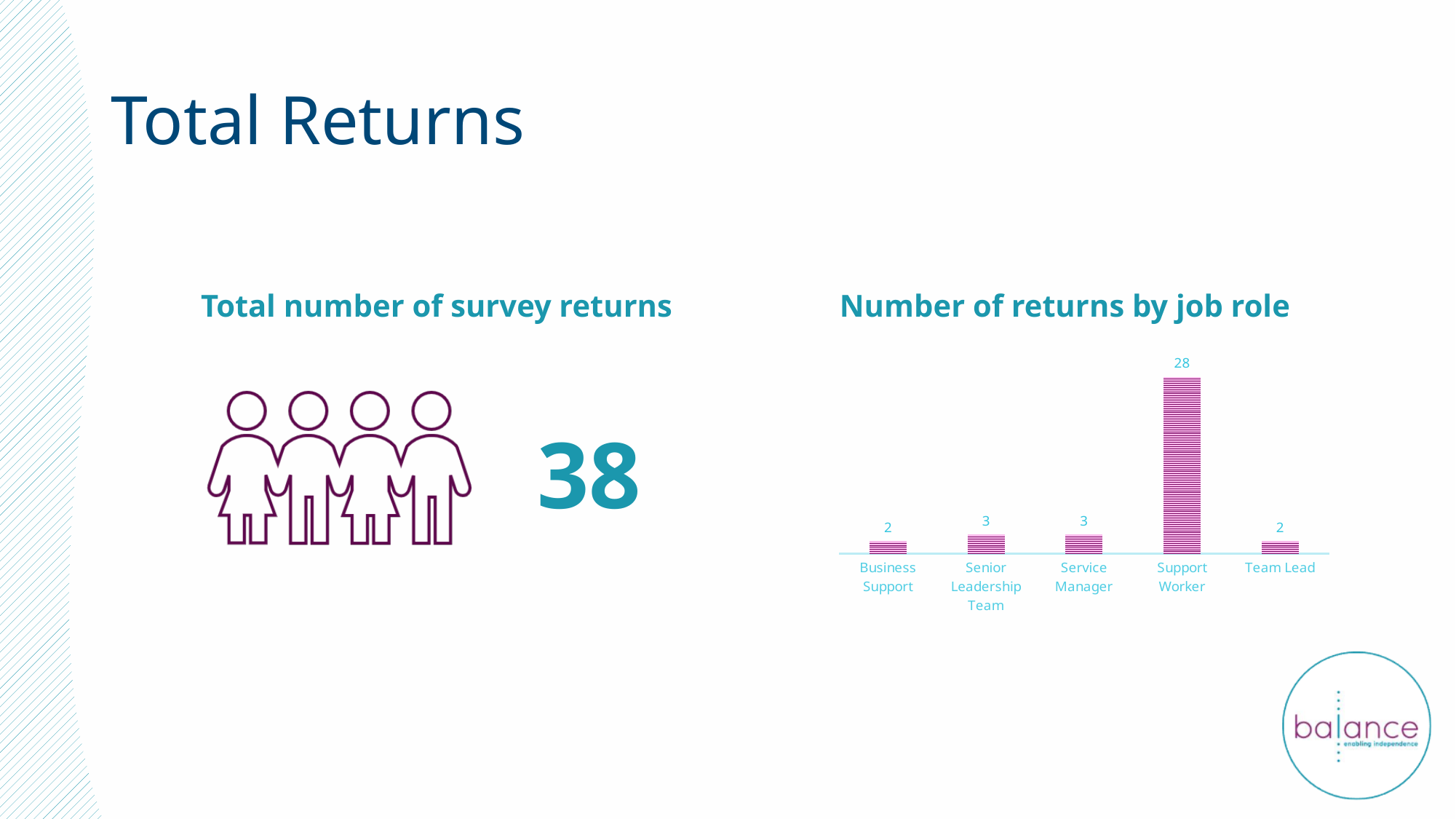
In the 'Number of returns by job role' chart, what is the value for Senior Leadership Team? 3 In the 'Number of returns by job role' chart, which is larger, the value for Senior Leadership Team or the value for Business Support? Senior Leadership Team In the 'Number of returns by job role' chart, what is the value for Team Lead? 2 What is the title of the chart on the right of the slide? Number of returns by job role In the 'Number of returns by job role' chart, what is the difference between the values for Support Worker and Service Manager? 25 What kind of chart is the 'Number of returns by job role' chart? bar chart How many job role categories are shown in the 'Number of returns by job role' chart? 5 In the 'Number of returns by job role' chart, what is the difference between the values for Service Manager and Team Lead? 1 In the 'Number of returns by job role' chart, what is the value for Business Support? 2 What colour are the bars in the 'Number of returns by job role' chart? Pink/magenta In the 'Number of returns by job role' chart, which job role has the highest number of returns? Support Worker In the 'Number of returns by job role' chart, what is the value for Support Worker? 28